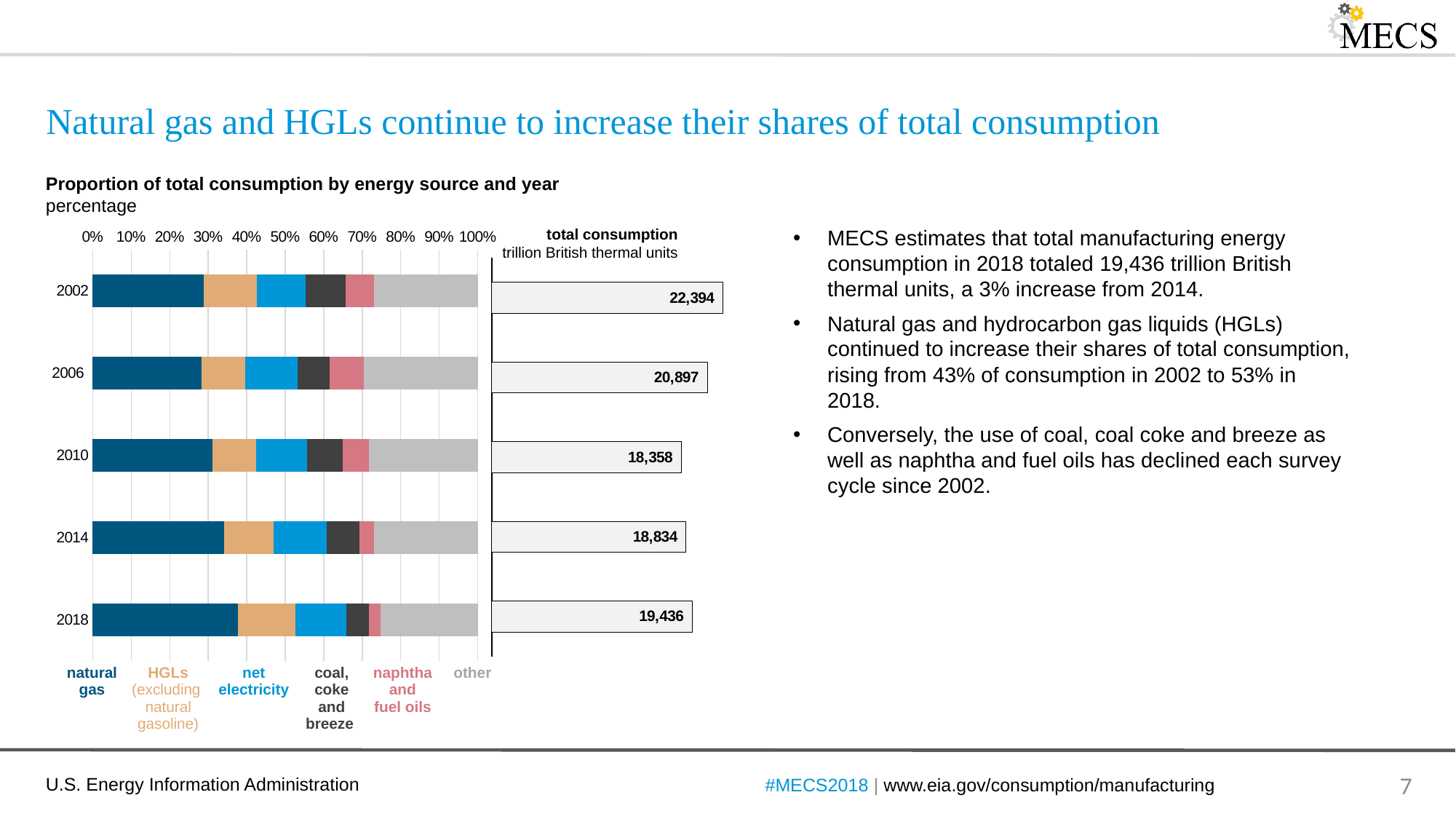
What kind of chart is the proportion of total consumption by energy source and year chart? stacked bar chart How many years are shown on the proportion of total consumption chart? 5 On the total consumption chart, what was total consumption in 2010? 18,358 On the total consumption chart, what is the difference between total consumption in 2002 and in 2006? 1,497 On the total consumption chart, which year had the highest total consumption? 2002 On the total consumption chart, what was total consumption in 2002? 22,394 On the total consumption chart, what is the difference between total consumption in 2018 and in 2014? 602 On the total consumption chart, what was total consumption in 2018? 19,436 On the total consumption chart, which year had higher total consumption, 2014 or 2010? 2014 On the proportion of total consumption chart, is the natural gas share in 2018 greater or less than 30%? greater How many energy sources does the legend of the proportion of total consumption chart list? 6 On the total consumption chart, which year had the lowest total consumption? 2010